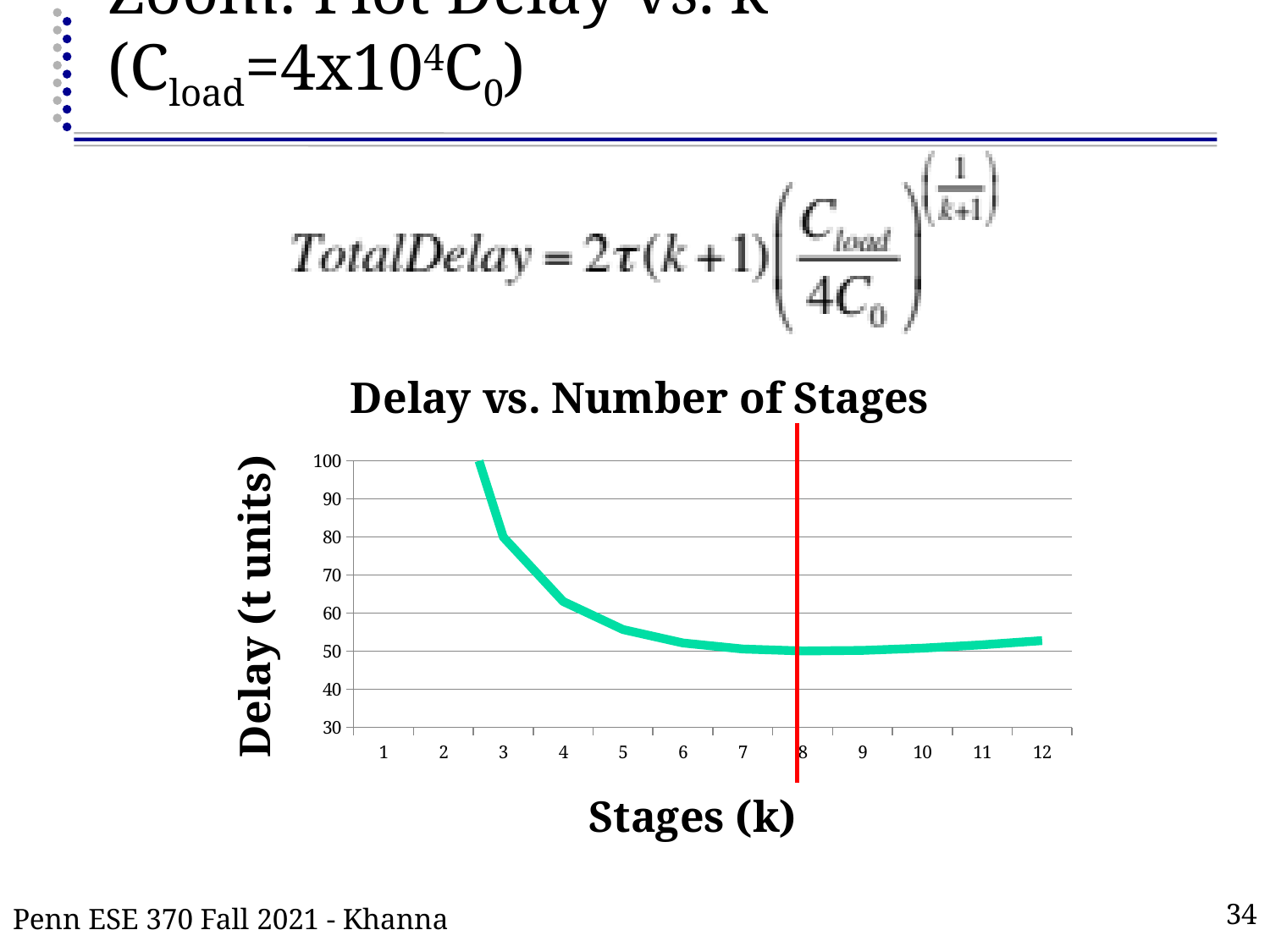
Is the delay value at k = 4 greater or less than 70? less Is the delay value at k = 5 greater or less than 60? less Is the delay value at k = 3 greater or less than 70? greater What is the label of the y axis of the chart? Delay (t units) How many stage values (k) are marked along the x axis of the chart? 12 What is the title of the chart? Delay vs. Number of Stages Does the delay rise or fall as k increases from 3 to 7? fall Which has the larger delay, k = 4 or k = 12? k = 4 Which has the larger delay, k = 3 or k = 5? k = 3 What kind of chart is shown on the slide? line chart